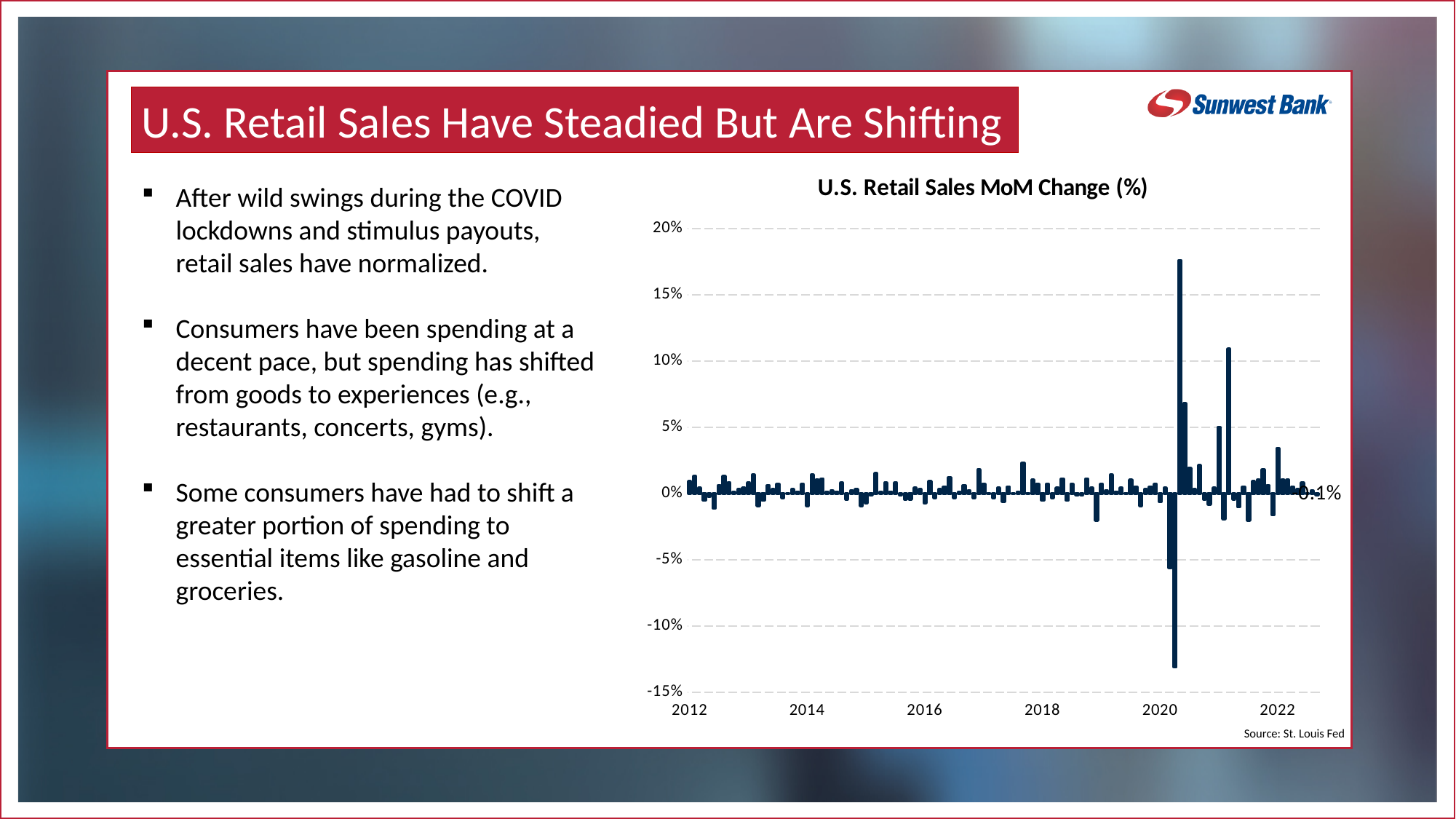
In which year on the x axis does the tallest positive bar occur? 2020 In which year on the x axis does the lowest negative bar occur? 2020 What is the highest value shown on the y axis of the chart? 20% How many year labels are shown on the x axis of the chart? 6 Which is larger: the tallest bar in 2020 or the tallest bar in 2021? the tallest bar in 2020 Is the value of the tallest bar in 2021 greater or less than 5%? greater What is the first year label on the x axis of the chart? 2012 Is the value of the tallest bar in 2020 greater or less than 15%? greater What is the title of the chart? U.S. Retail Sales MoM Change (%) What value is printed as the data label on the most recent bar of the chart? 0.1% Is the value of the lowest bar in 2020 greater or less than -10%? less What kind of chart is shown on the slide? bar chart